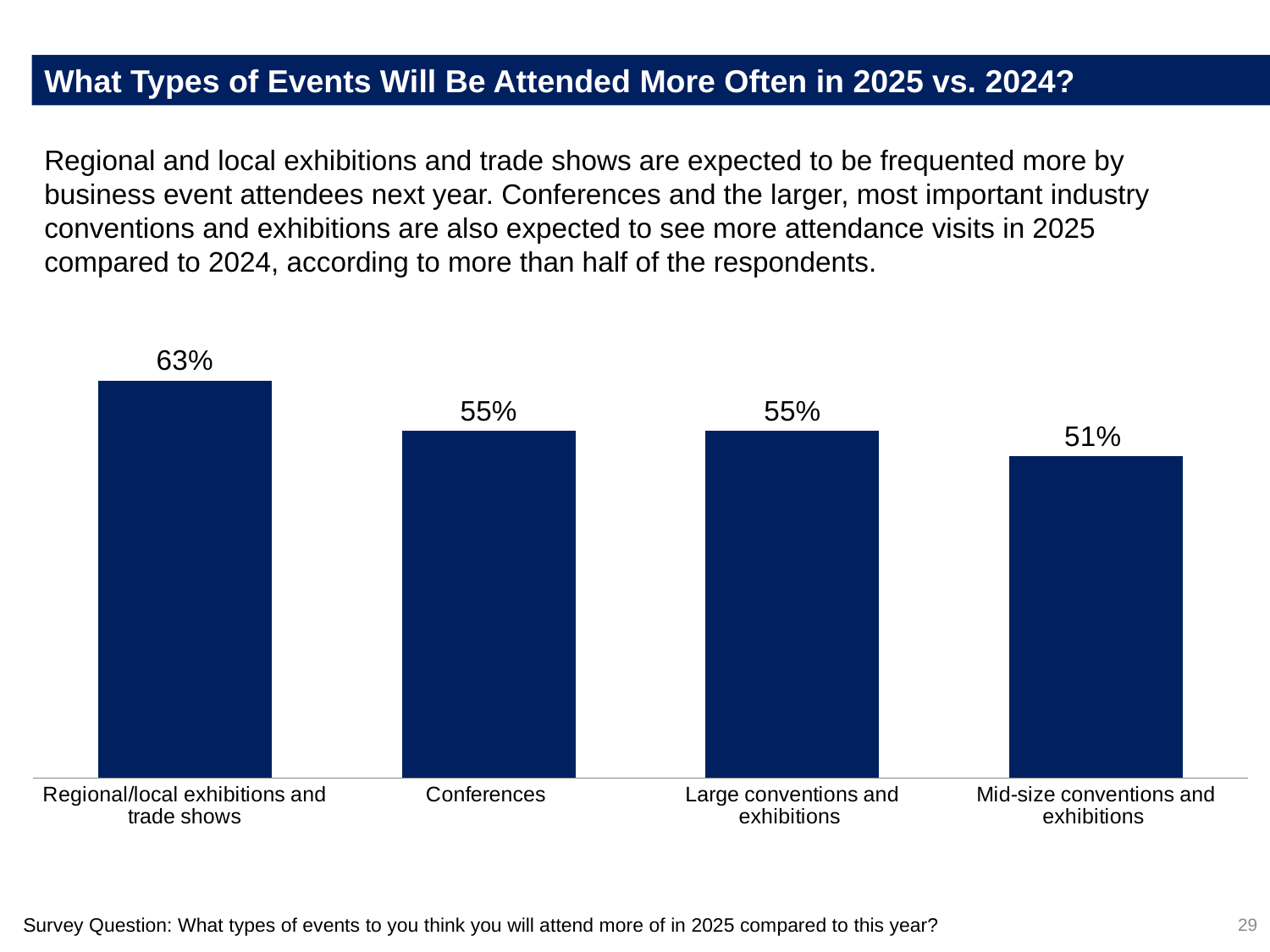
What is the value shown for Mid-size conventions and exhibitions? 51% What is the value shown for Large conventions and exhibitions? 55% How many event types are shown in the chart? 4 Which is larger: the value for Regional/local exhibitions and trade shows or the value for Conferences? Regional/local exhibitions and trade shows What is the value shown for Conferences? 55% What kind of chart is shown on the slide? Bar chart Do the values rise or fall from left to right across the chart? Fall What is the difference in percentage points between Regional/local exhibitions and trade shows and Mid-size conventions and exhibitions? 12 percentage points What percentage of respondents expect to attend more regional/local exhibitions and trade shows in 2025? 63% What is the difference between the values for Conferences and Mid-size conventions and exhibitions? 4 percentage points Which event type has the lowest percentage? Mid-size conventions and exhibitions Which event type has the highest percentage? Regional/local exhibitions and trade shows